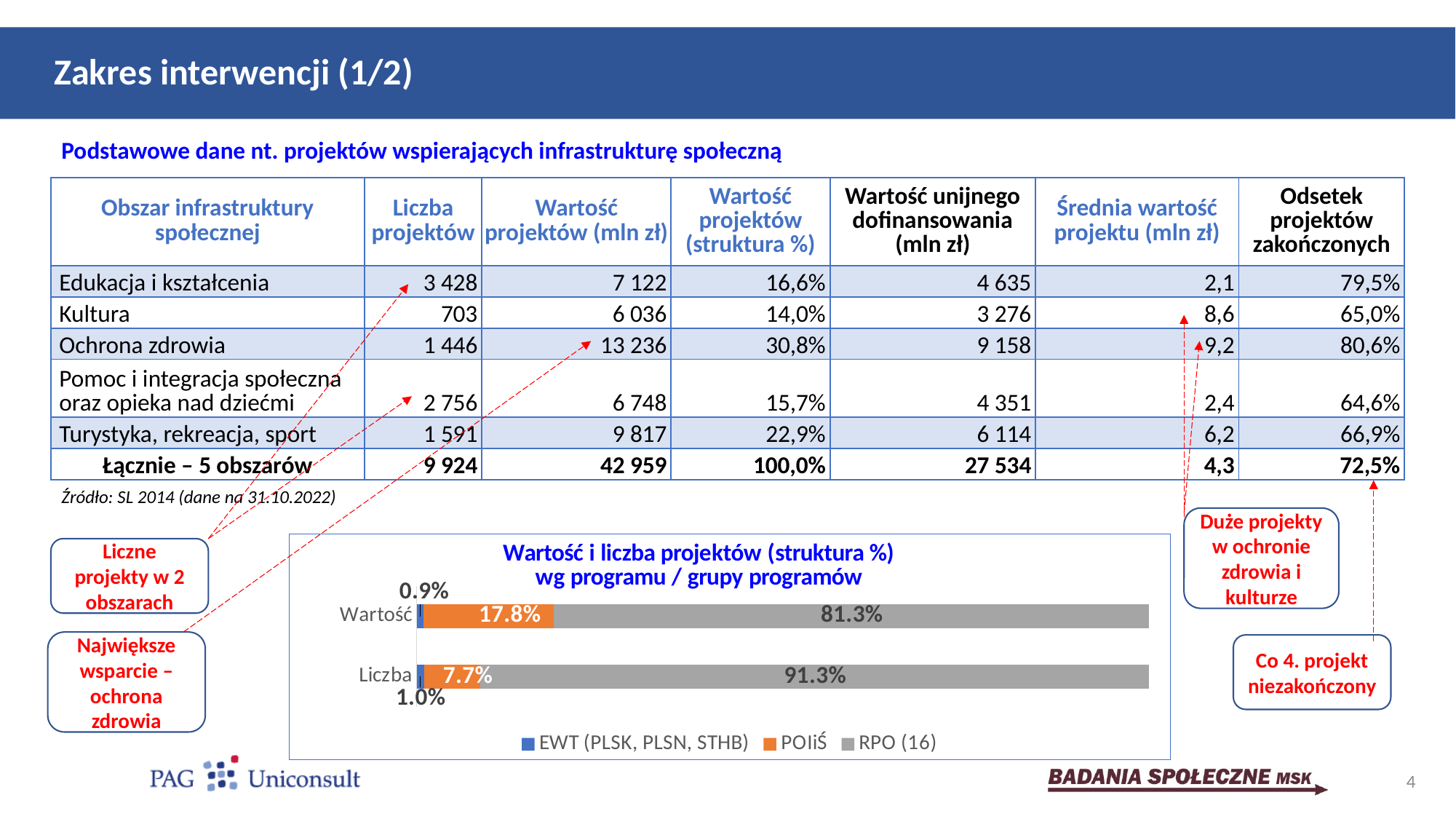
Is the RPO (16) share larger in the Wartość bar or in the Liczba bar? Liczba Which series has the smallest share in the Wartość bar? EWT (PLSK, PLSN, STHB) What is the value for EWT (PLSK, PLSN, STHB) in the Wartość bar? 0.9% What is the value for EWT (PLSK, PLSN, STHB) in the Liczba bar? 1.0% How many categories (bars) are plotted in the chart? 2 What is the value for RPO (16) in the Wartość bar? 81.3% What is the title of the chart on the slide? Wartość i liczba projektów (struktura %) wg programu / grupy programów What kind of chart is shown on the slide? Stacked bar chart How many series does the chart's legend list? 3 What is the difference between the POIiŚ share in the Wartość bar and the POIiŚ share in the Liczba bar? 10.1 percentage points Which series has the largest share in the Liczba bar? RPO (16) What is the value for POIiŚ in the Liczba bar? 7.7%